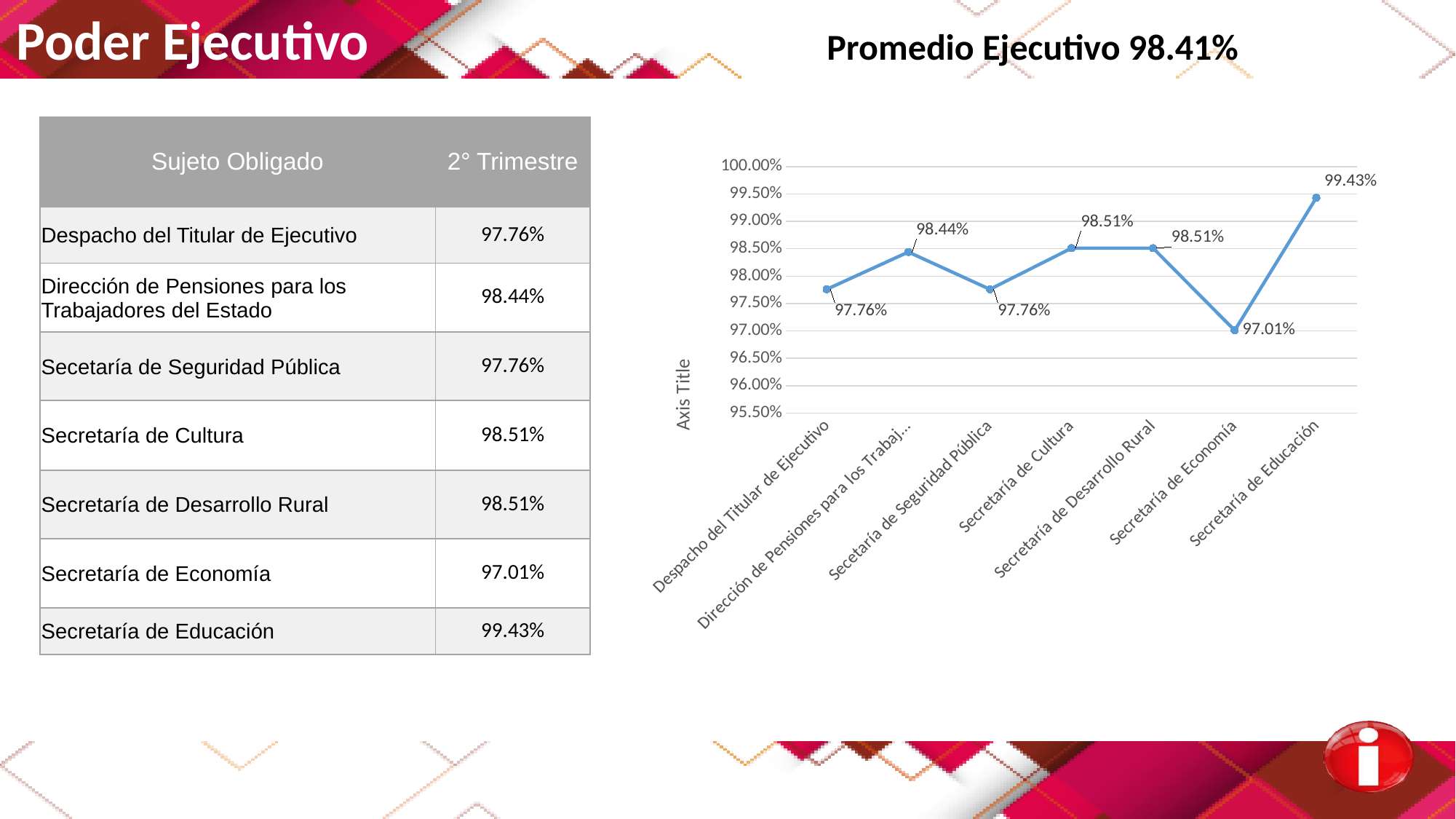
Which category has the lowest value in the chart? Secretaría de Economía What is the label of the vertical axis of the chart? Axis Title What is the value for Despacho del Titular de Ejecutivo in the chart? 97.76% Which category has the highest value in the chart? Secretaría de Educación What is the difference between the values for Secretaría de Educación and Secretaría de Economía? 2.42% What type of chart is shown on the slide? line chart Is the value for Secretaría de Economía greater or less than 97.50%? less What is the value for Secretaría de Cultura in the chart? 98.51% Which is larger, the value for Secretaría de Cultura or the value for Secretaría de Seguridad Pública? Secretaría de Cultura What is the value for Secretaría de Educación in the chart? 99.43% How many categories are plotted on the x axis of the chart? 7 What is the value for Secretaría de Economía in the chart? 97.01%